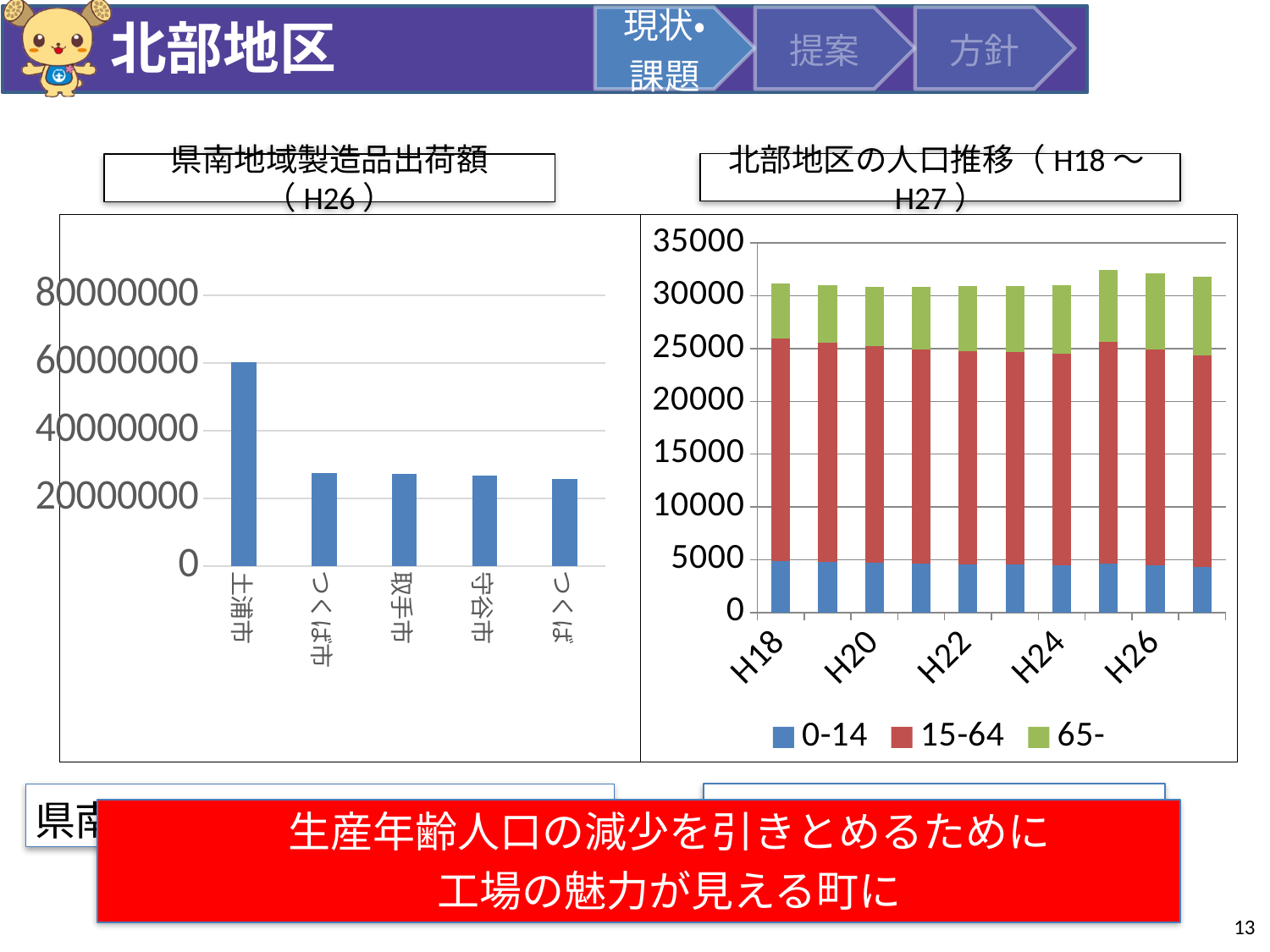
In the left chart, 県南地域製造品出荷額（H26）, is the value for 土浦市 greater or less than 40000000? greater What kind of chart is the right chart, 北部地区の人口推移（H18～H27）? stacked bar chart How many bars are plotted in the right chart, 北部地区の人口推移（H18～H27）? 10 How many cities are shown in the left chart, 県南地域製造品出荷額（H26）? 5 How many series does the legend of the right chart, 北部地区の人口推移（H18～H27）, list? 3 In the left chart, 県南地域製造品出荷額（H26）, which is larger, the value for 土浦市 or the value for 取手市? 土浦市 What are the legend entries of the right chart, 北部地区の人口推移（H18～H27）? 0-14, 15-64, 65- In the right chart, 北部地区の人口推移（H18～H27）, is the total for H18 greater or less than 25000? greater In the right chart, 北部地区の人口推移（H18～H27）, is the 0-14 value for H18 greater or less than 10000? less What kind of chart is the left chart, 県南地域製造品出荷額（H26）? bar chart In the left chart, 県南地域製造品出荷額（H26）, which city has the highest value? 土浦市